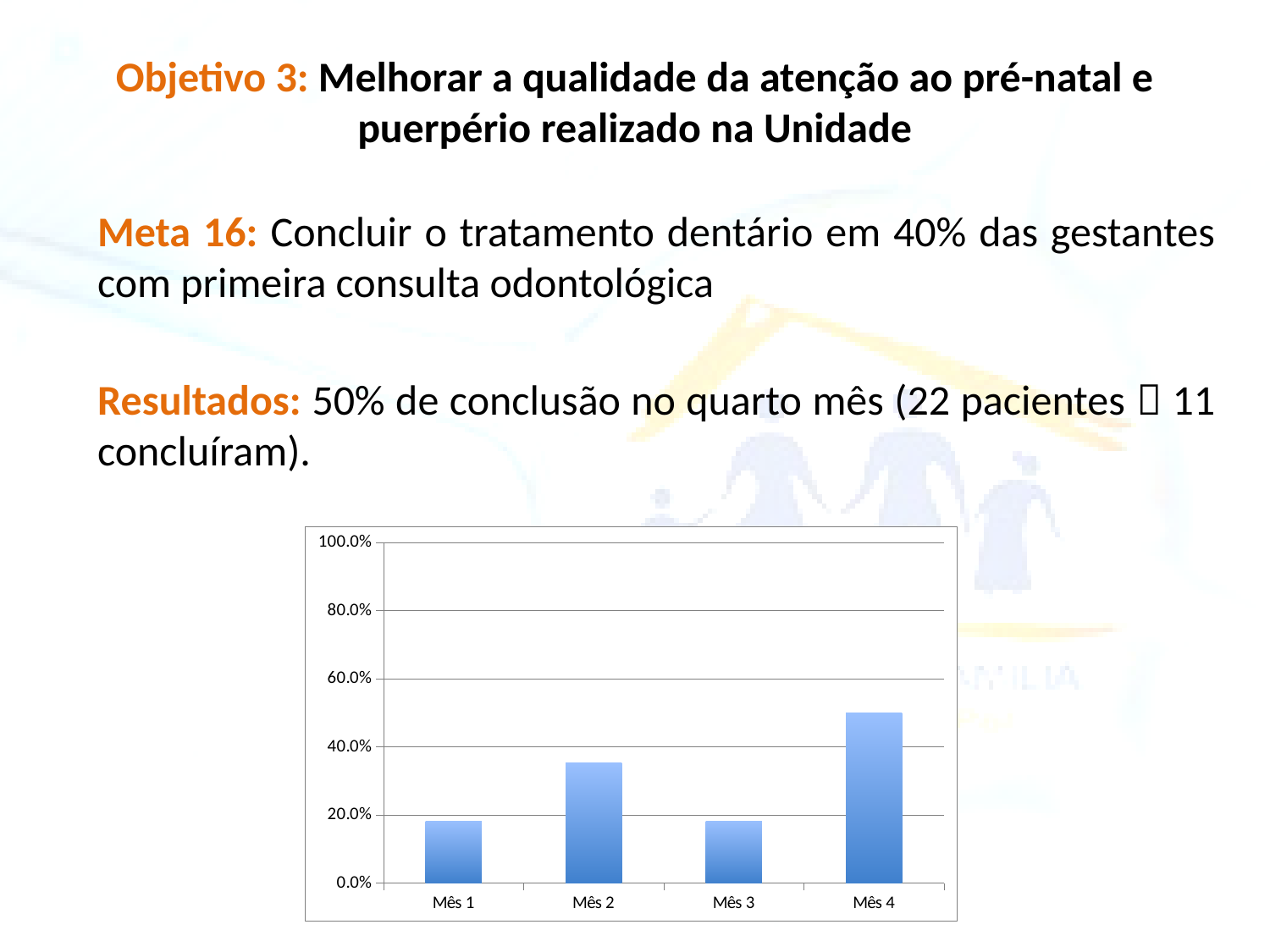
Which month has the highest bar on the chart? Mês 4 What kind of chart is shown on the slide? bar chart Is the value for Mês 2 greater or less than 20.0%? greater Is the value for Mês 1 greater or less than 20.0%? less Which is larger, the value for Mês 2 or the value for Mês 4? Mês 4 What is the highest value shown on the vertical axis of the chart? 100.0% What is the label of the first category on the horizontal axis? Mês 1 Is the value for Mês 2 greater or less than 40.0%? less How many categories (months) are plotted on the chart? 4 Which is larger, the value for Mês 1 or the value for Mês 2? Mês 2